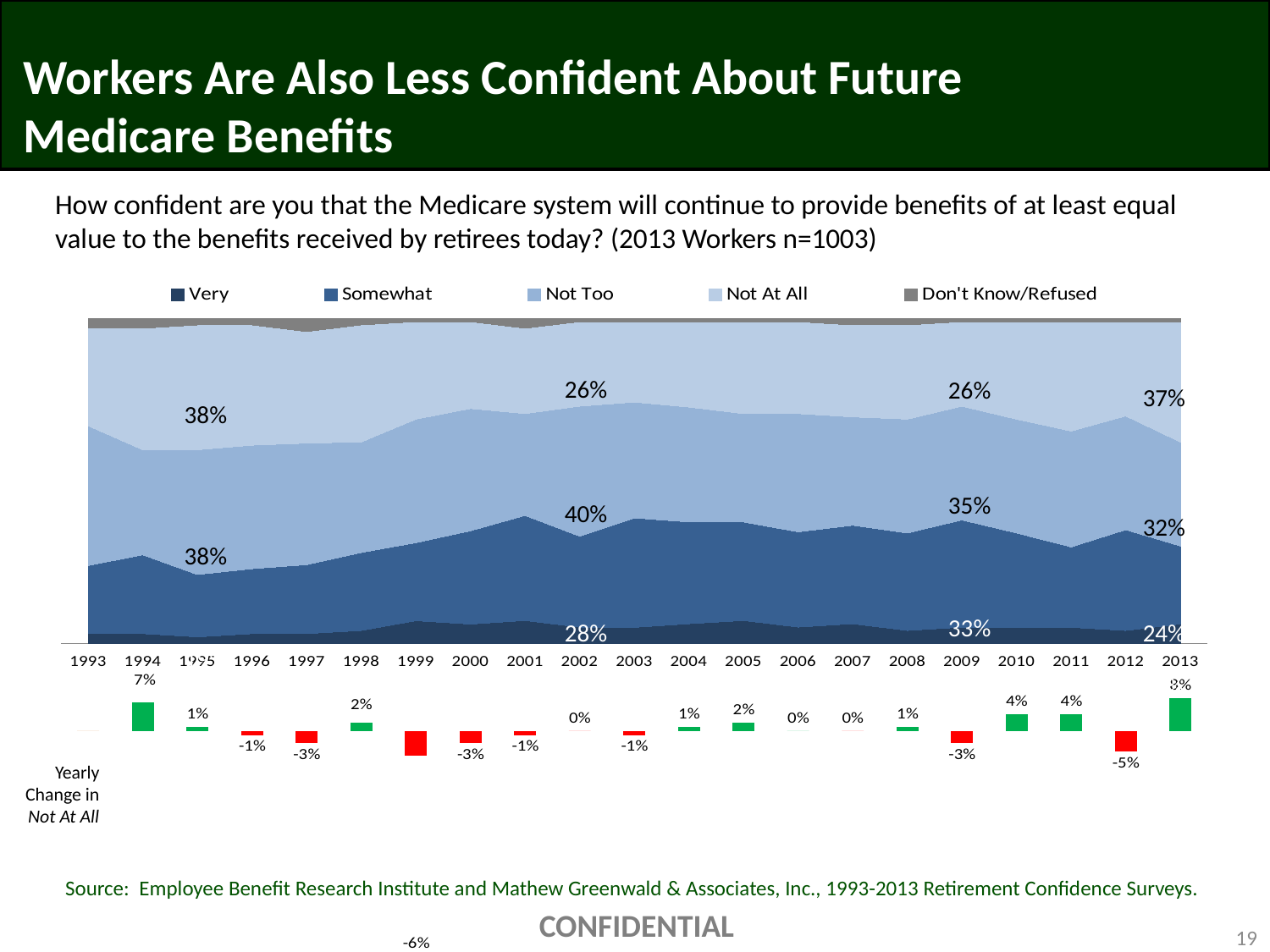
In the lower 'Yearly Change in Not At All' bar chart, which year has the lowest value? 1999 What kind of chart is the upper chart showing confidence levels from 1993 to 2013? Stacked area chart In the lower 'Yearly Change in Not At All' bar chart, what is the value for 2012? -5% What is the first entry in the legend of the upper stacked area chart? Very In the lower 'Yearly Change in Not At All' bar chart, what is the value for 1994? 7% In the lower 'Yearly Change in Not At All' bar chart, what is the difference between the 2010 value and the 2012 value? 9 percentage points In the upper stacked area chart, what is the labelled value for 'Not Too' in 2002? 40% How many series does the legend of the stacked area chart list? 5 In the lower 'Yearly Change in Not At All' bar chart, what is the value for 2010? 4% In the lower 'Yearly Change in Not At All' bar chart, which is larger, the value for 1997 or the value for 1998? 1998 In the upper stacked area chart, what is the labelled value for 'Not At All' in 2013? 37% How many years are shown on the x axis of the upper stacked area chart? 21